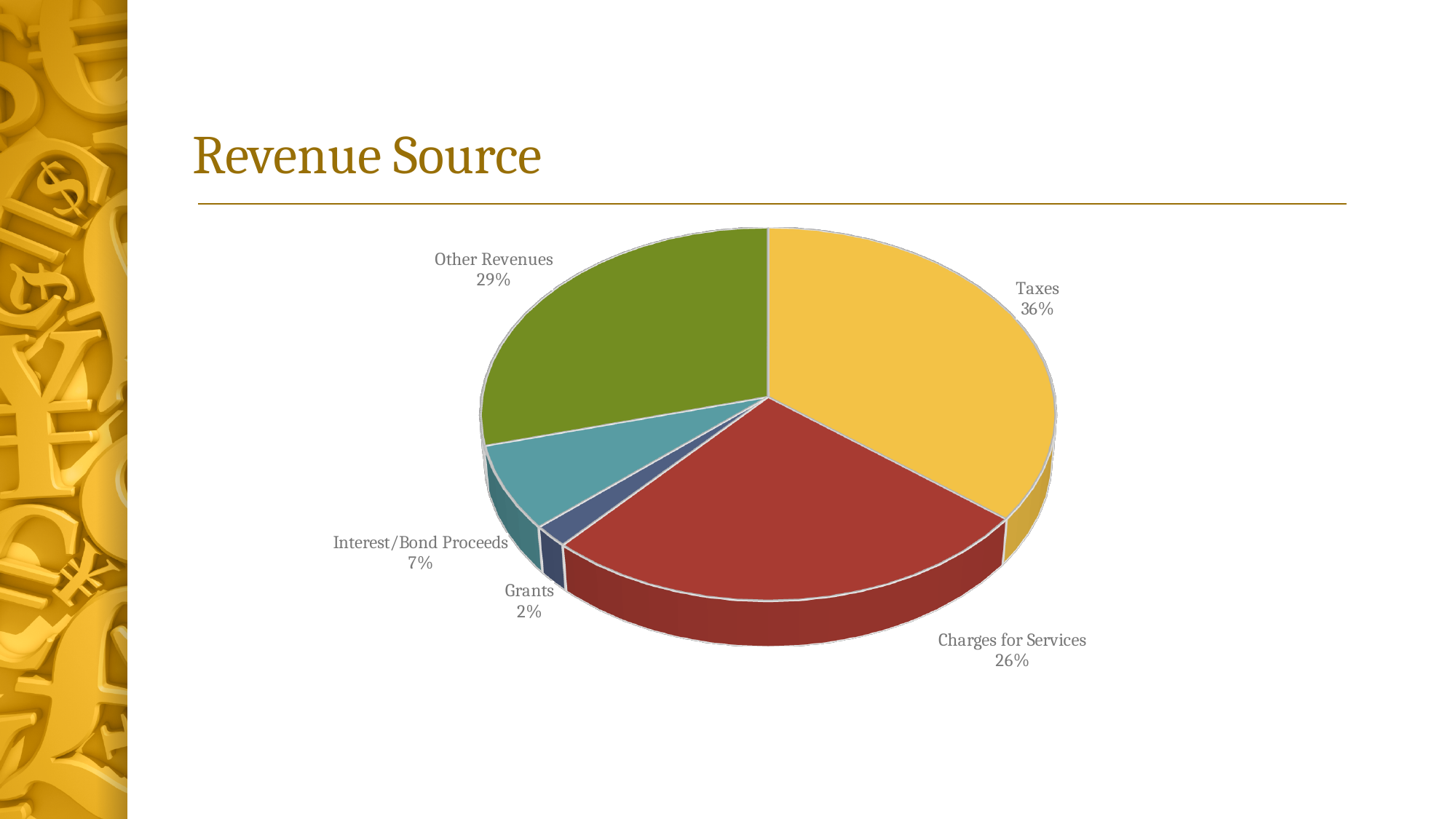
What share does Charges for Services represent? 26% What percentage is shown for Interest/Bond Proceeds? 7% What share of revenue comes from Grants? 2% How many percentage points larger is Taxes than Charges for Services? 10 What type of chart is shown on the slide? Pie chart What is the title of the slide? Revenue Source What share of revenue comes from Taxes? 36% Which revenue source has the smallest share? Grants Which revenue source has the largest share? Taxes What percentage of revenue is Other Revenues? 29% Which is larger, Other Revenues or Charges for Services? Other Revenues How many revenue sources are shown in the pie chart? 5